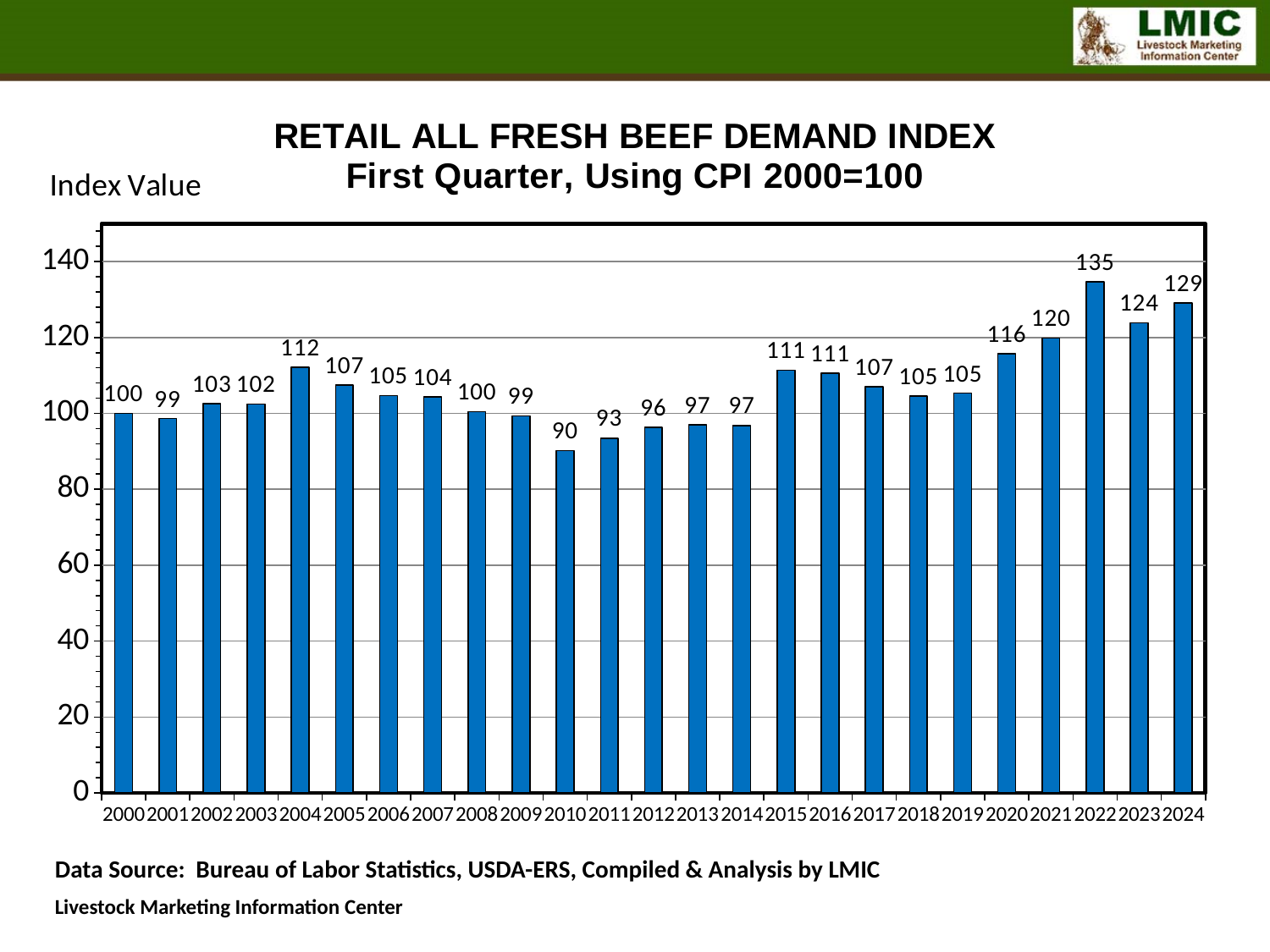
What is the index value for 2010? 90 How many years are shown on the x axis? 25 What is the difference between the index values for 2022 and 2010? 45 Is the index value for 2021 greater or less than 100? greater Which year has a higher index value, 2015 or 2020? 2020 What is the index value for 2004? 112 What is the title of the chart? RETAIL ALL FRESH BEEF DEMAND INDEX First Quarter, Using CPI 2000=100 What kind of chart is shown on the slide? Bar chart What is the index value for 2022? 135 Do the index values generally rise or fall from 2014 to 2022? Rise Which year has the highest index value? 2022 Which year has the lowest index value? 2010